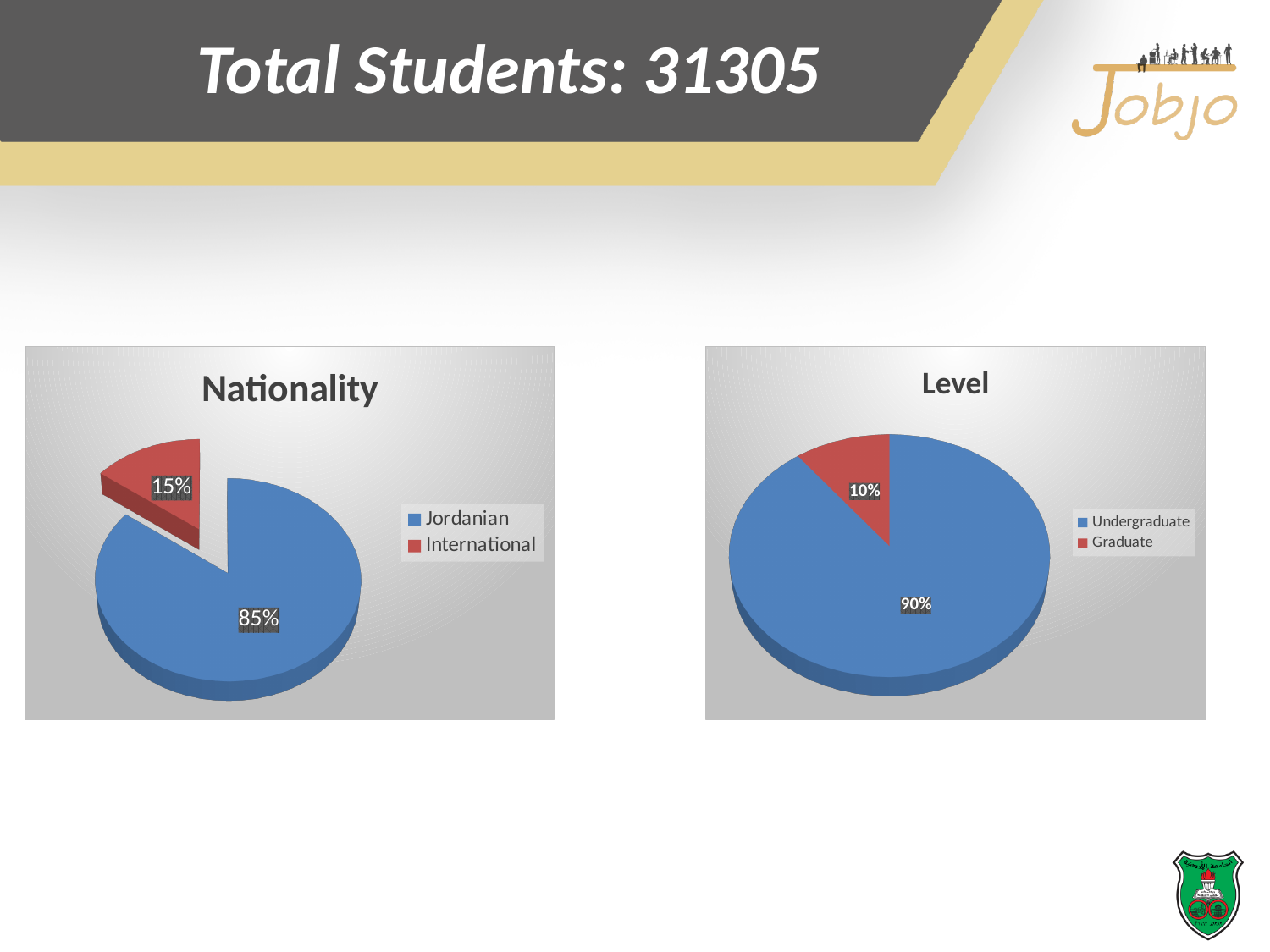
What kind of chart is the Level chart? Pie chart In the Level chart, what share of students are Undergraduate? 90% How many entries does the legend of the Level chart list? 2 In the Level chart, what is the difference in percentage points between the Undergraduate and Graduate slices? 80 How many slices does the Nationality chart have? 2 In the Nationality chart, what share of students are International? 15% In the Nationality chart, which colour represents the International slice? Red In the Nationality chart, which category has the largest slice? Jordanian In the Nationality chart, what is the difference in percentage points between the Jordanian and International slices? 70 In the Level chart, what share of students are Graduate? 10% In the Level chart, which category has the smallest slice? Graduate